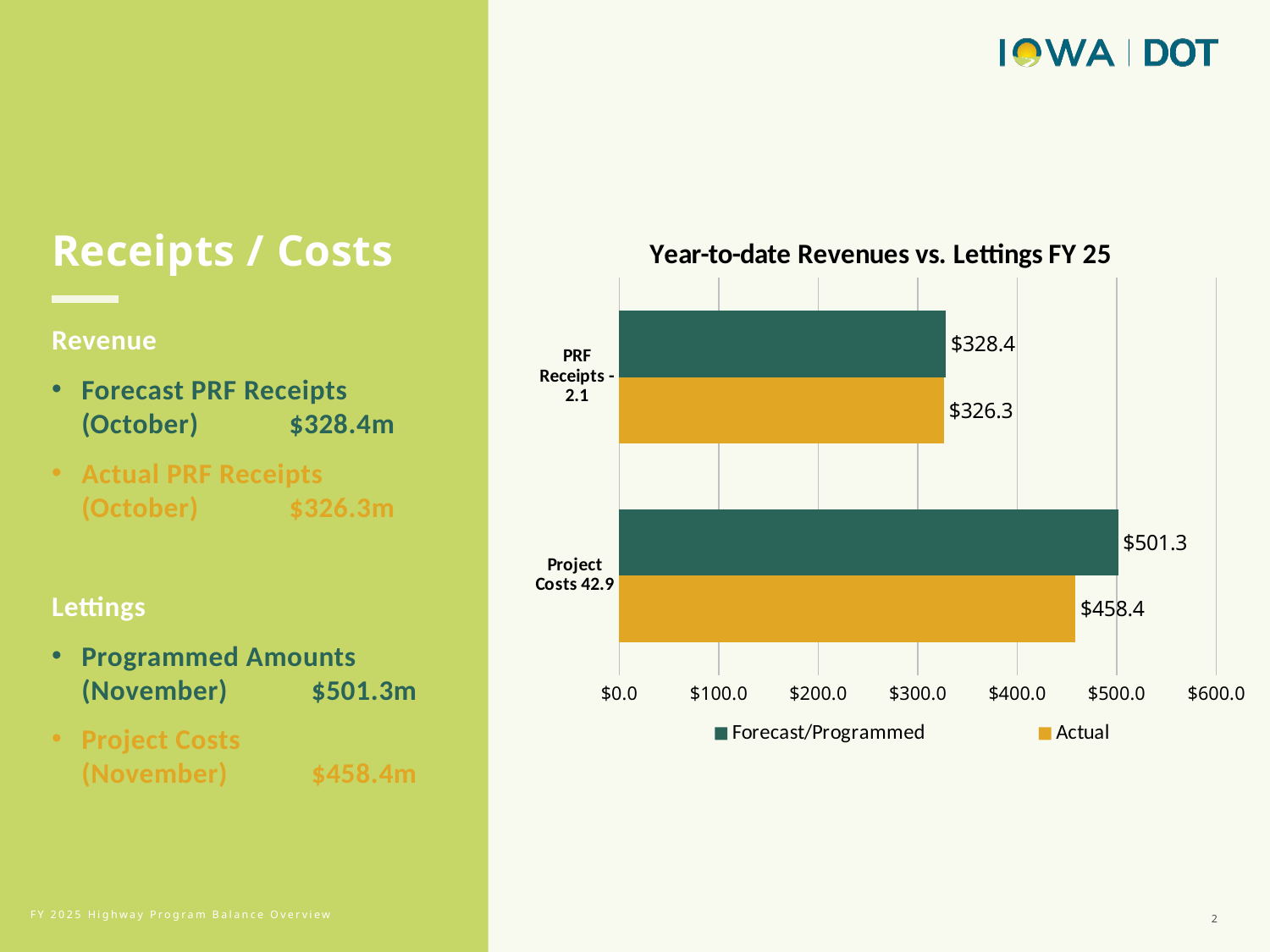
What is the title of the chart? Year-to-date Revenues vs. Lettings FY 25 What is the Actual value for PRF Receipts - 2.1? $326.3 What is the Actual value for Project Costs 42.9? $458.4 Which is larger for Project Costs 42.9: the Forecast/Programmed value or the Actual value? Forecast/Programmed Which category has the highest Forecast/Programmed value? Project Costs 42.9 What is the difference between the Forecast/Programmed and Actual values for Project Costs 42.9? $42.9 What is the Forecast/Programmed value for PRF Receipts - 2.1? $328.4 How many series does the legend list? 2 Which category has the lowest Actual value? PRF Receipts - 2.1 What is the difference between the Forecast/Programmed and Actual values for PRF Receipts - 2.1? $2.1 What kind of chart is shown on the slide? Bar chart What is the Forecast/Programmed value for Project Costs 42.9? $501.3